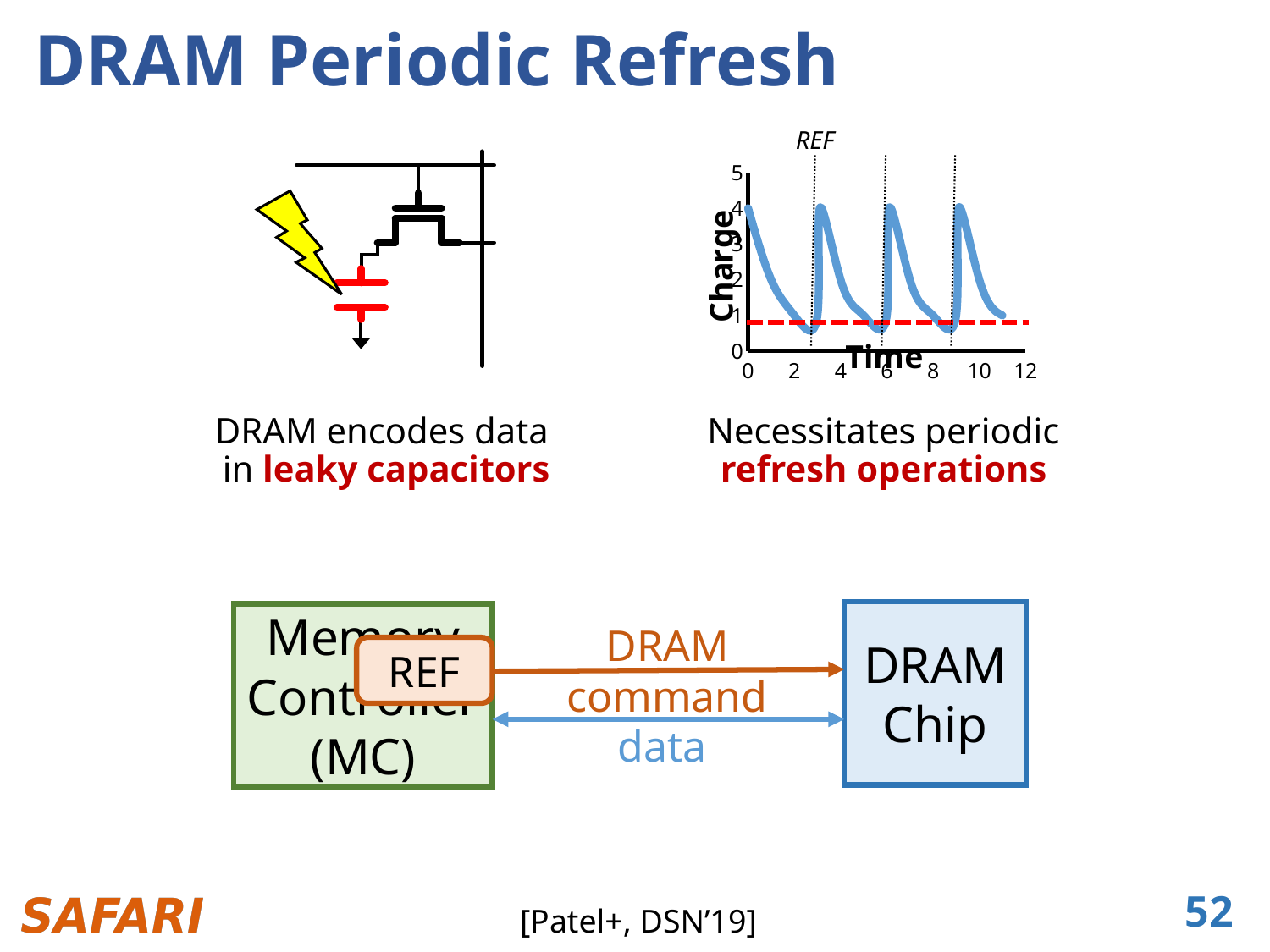
What is the label of the vertical axis of the chart? Charge Is the peak charge reached right after a refresh greater or less than 3? greater What is the highest tick value shown on the Time axis? 12 How many REF (refresh) events, marked by vertical dotted lines, are shown on the chart? 3 What kind of chart is shown on the slide? line chart Is the charge at time 0 greater or less than 3? greater Is the lowest charge reached just before a refresh greater or less than 2? less Is the charge at time 2 greater or less than the charge at time 4? less Between two refresh operations, does the charge rise or fall as time increases? fall What is the label of the horizontal axis of the chart? Time What is the highest tick value shown on the Charge axis? 5